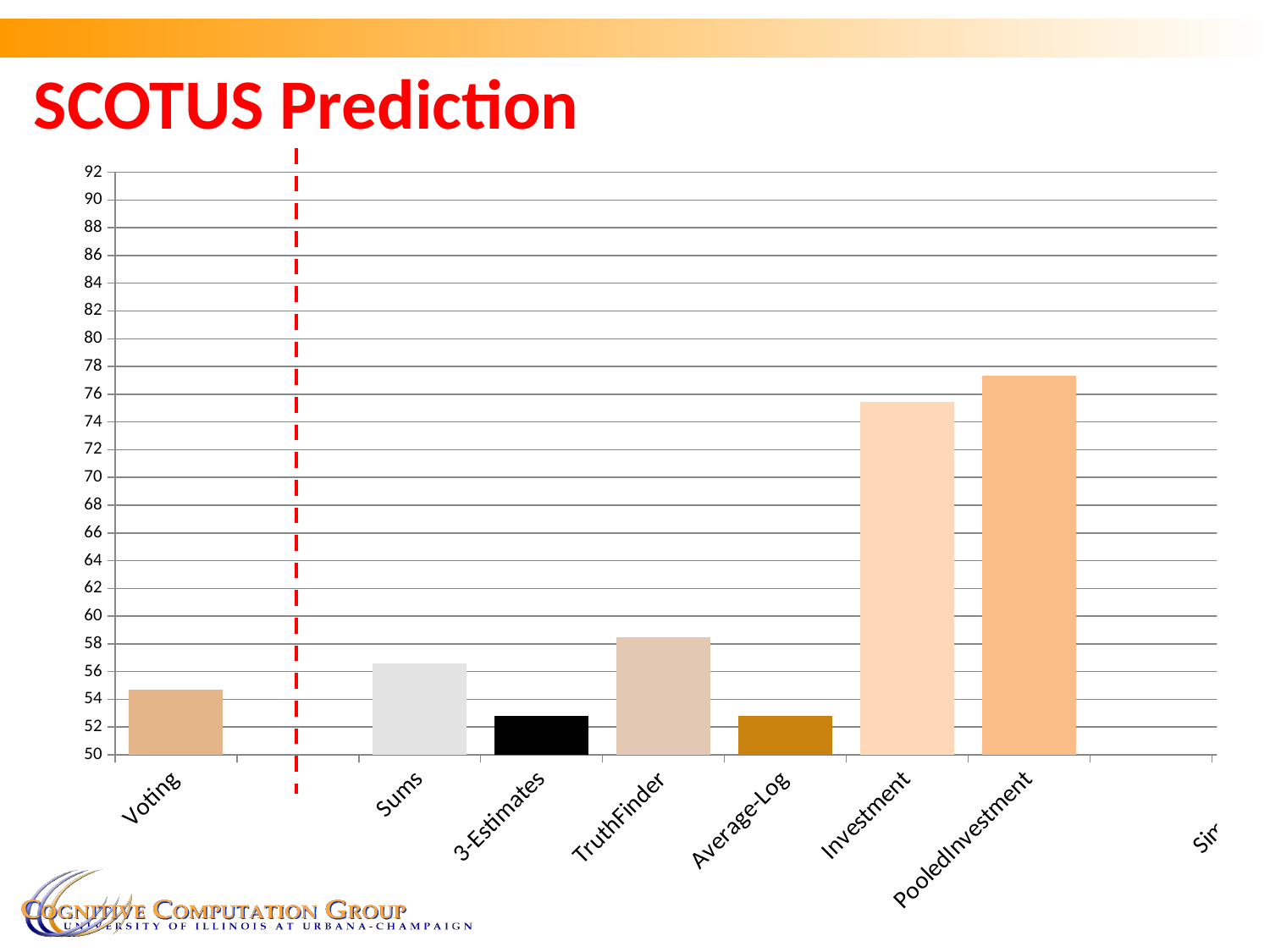
Is the value for TruthFinder greater or less than 56? greater Which is larger, the value for Voting or the value for Sums? Sums What is the title of the slide containing the chart? SCOTUS Prediction Which is larger, the value for PooledInvestment or the value for Investment? PooledInvestment Which is larger, the value for TruthFinder or the value for Sums? TruthFinder Is the value for Sums greater or less than 58? less Is the value for PooledInvestment greater or less than 80? less What kind of chart is shown on the slide? bar chart Which category has the highest bar? PooledInvestment